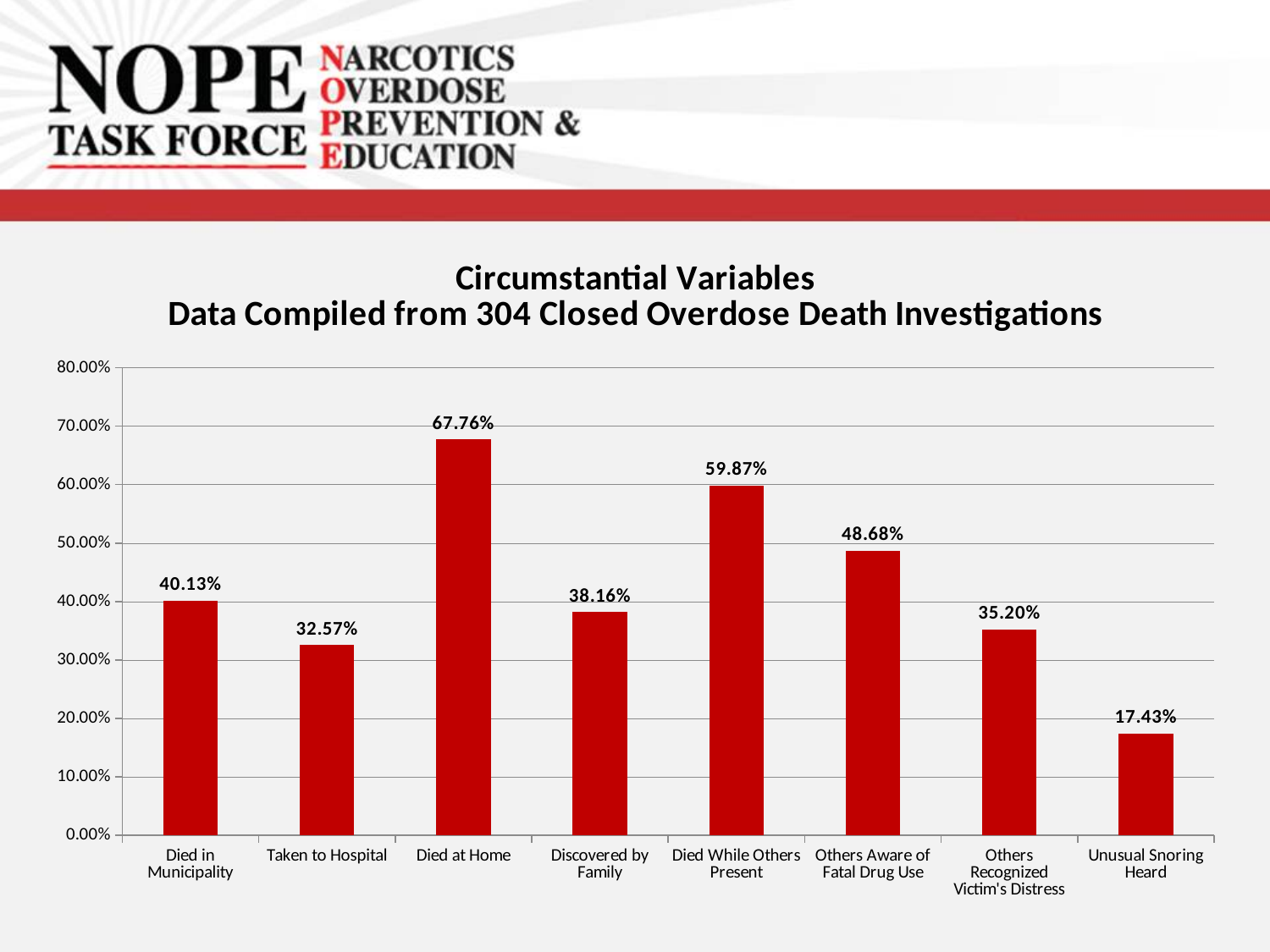
What is the value for Others Aware of Fatal Drug Use? 48.68% What kind of chart is shown on the slide? bar chart What is the value for Died at Home? 67.76% How many categories are shown on the chart? 8 How many closed overdose death investigations does the chart title say the data was compiled from? 304 What is the difference between the values for Discovered by Family and Taken to Hospital? 5.59% Is the value for Others Recognized Victim's Distress greater or less than 40.00%? less Which is larger, the value for Died in Municipality or the value for Taken to Hospital? Died in Municipality What is the difference between the values for Died at Home and Died While Others Present? 7.89% What is the value for Unusual Snoring Heard? 17.43% Which category has the highest value? Died at Home Which category has the lowest value? Unusual Snoring Heard